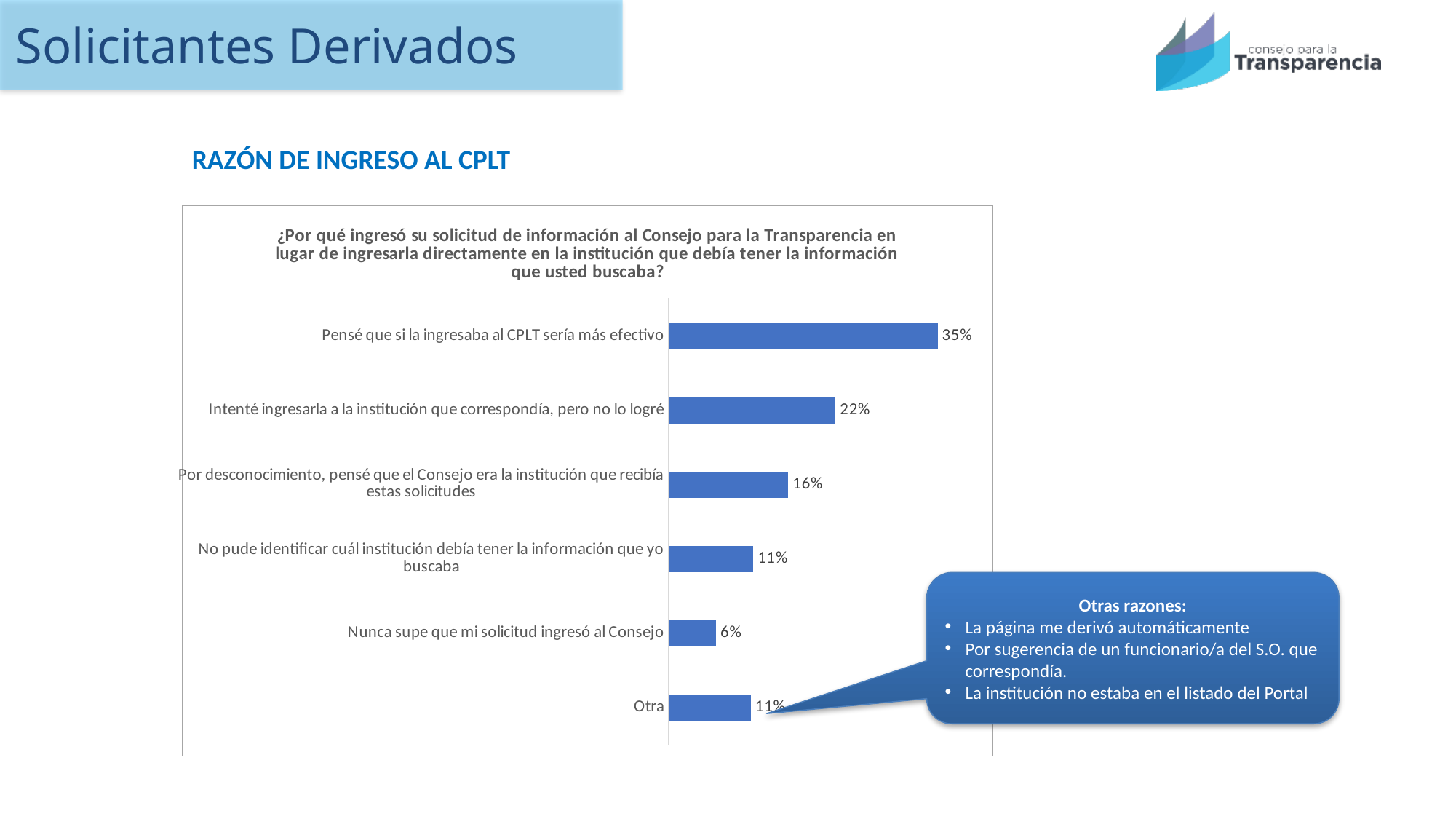
What is the difference between the values for "Otra" and "Nunca supe que mi solicitud ingresó al Consejo"? 5% What is the difference between the values for "Pensé que si la ingresaba al CPLT sería más efectivo" and "Intenté ingresarla a la institución que correspondía, pero no lo logré"? 13% What is the value for "Otra"? 11% Which reason has the highest percentage? Pensé que si la ingresaba al CPLT sería más efectivo What kind of chart is shown on the slide? Bar chart What percentage of respondents said "Pensé que si la ingresaba al CPLT sería más efectivo"? 35% Which reason has the lowest percentage? Nunca supe que mi solicitud ingresó al Consejo What is the value for "Nunca supe que mi solicitud ingresó al Consejo"? 6% Which is larger: the value for "Por desconocimiento, pensé que el Consejo era la institución que recibía estas solicitudes" or for "No pude identificar cuál institución debía tener la información que yo buscaba"? Por desconocimiento, pensé que el Consejo era la institución que recibía estas solicitudes What is the value for "Intenté ingresarla a la institución que correspondía, pero no lo logré"? 22% What is the heading shown above the chart on the slide? RAZÓN DE INGRESO AL CPLT How many reason categories are shown in the chart? 6